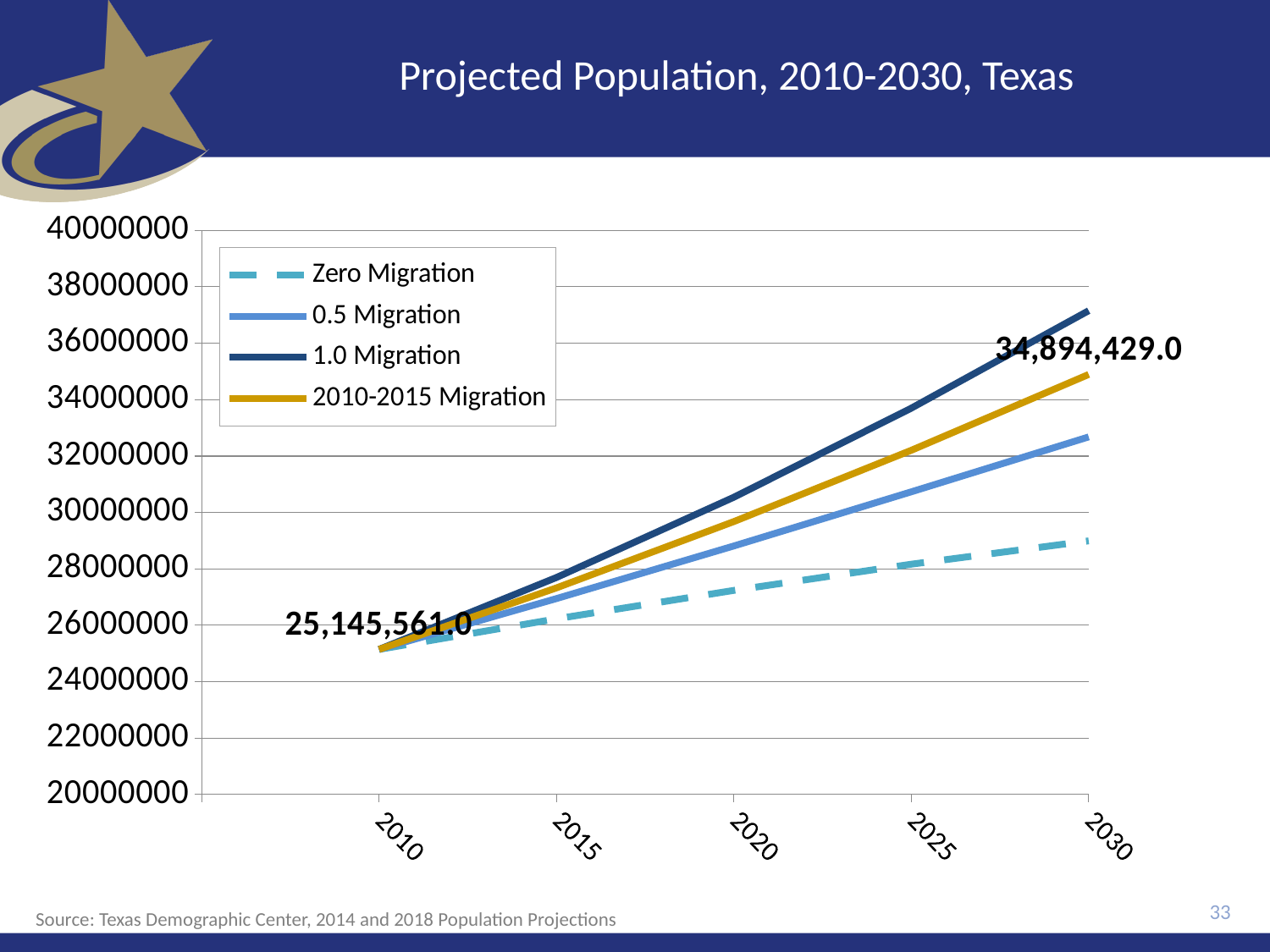
Which series has the lowest value in 2030? Zero Migration What kind of chart is shown on the slide? line chart How many years are labelled on the x axis? 5 What is the labelled value for the 2010-2015 Migration series in 2030? 34,894,429.0 What is the labelled population value in 2010? 25,145,561.0 Is the value for 1.0 Migration in 2030 greater or less than 36000000? greater Is the value for Zero Migration in 2030 greater or less than 30000000? less What is the difference between the labelled 2030 value for 2010-2015 Migration and the labelled 2010 value? 9,748,868.0 Do the projected population values rise or fall from 2010 to 2030? rise How many series does the legend list? 4 Which series has the highest value in 2030? 1.0 Migration Which series is drawn with a dashed line? Zero Migration